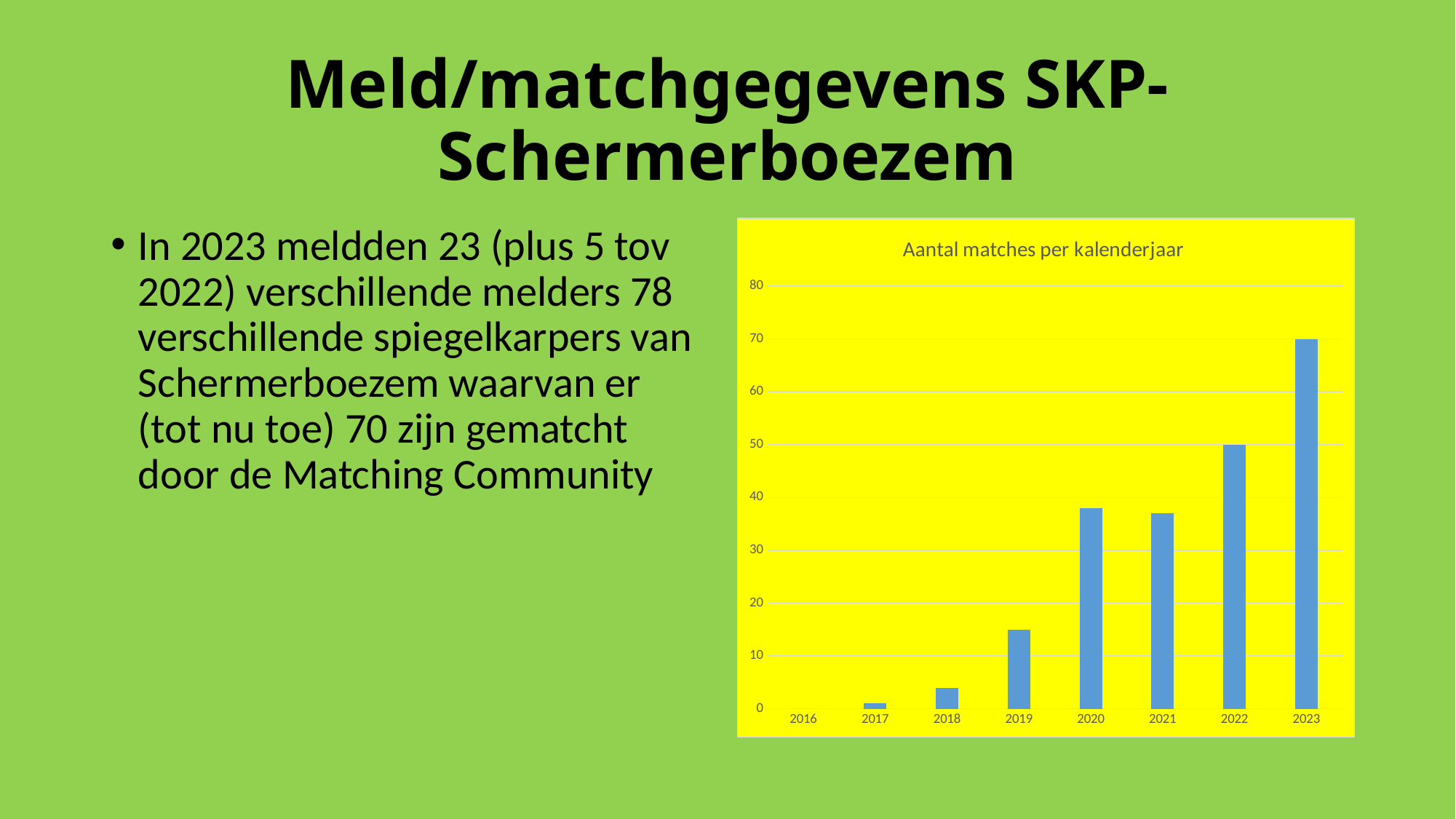
What is the number of matches for 2023? 70 How many years are shown on the x axis of the chart? 8 Which year has the highest number of matches? 2023 What is the title of the chart? Aantal matches per kalenderjaar Is the value for 2020 greater or less than 30? greater What is the difference in matches between 2023 and 2022? 20 Do the values generally rise or fall from 2016 to 2023? rise What is the number of matches for 2022? 50 What kind of chart is shown on the slide? bar chart Is the value for 2019 greater or less than 20? less Which is larger, the value for 2019 or the value for 2021? 2021 Is the value for 2018 greater or less than 10? less